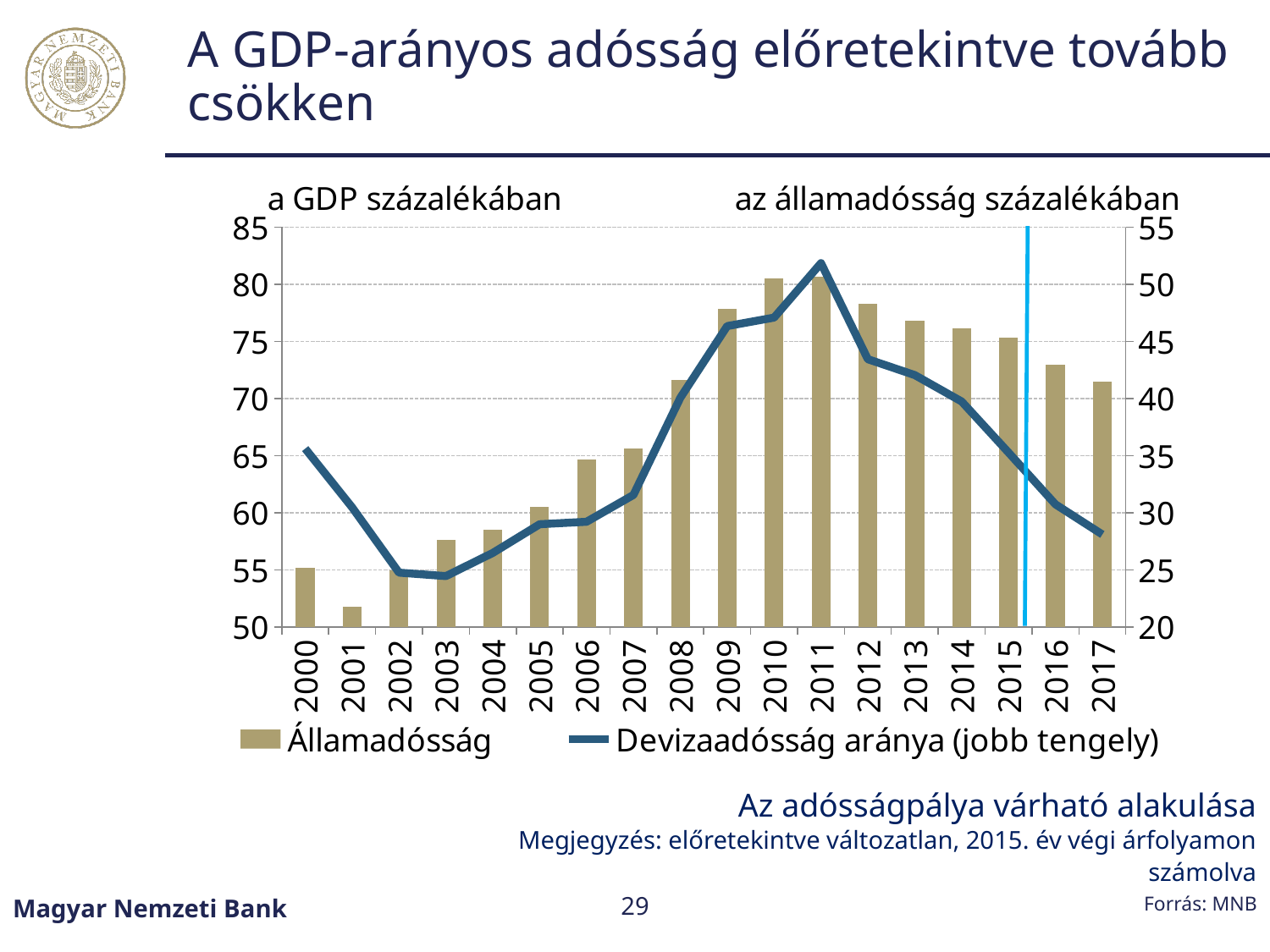
Is the Államadósság value for 2009 greater or less than 75? greater What kind of chart is shown on the slide? A combined bar and line chart Which year has the lowest Államadósság bar? 2001 How many years are shown on the x axis? 18 Which is larger, the Államadósság bar for 2000 or for 2017? 2017 Is the Devizaadósság aránya value for 2011 greater or less than 50 on the right axis? greater In which year does the Devizaadósság aránya line reach its highest point? 2011 Is the Államadósság value for 2001 greater or less than 55? less Does the Államadósság series rise or fall from 2011 to 2017? fall How many series does the legend list? 2 What is the label of the left vertical axis? a GDP százalékában